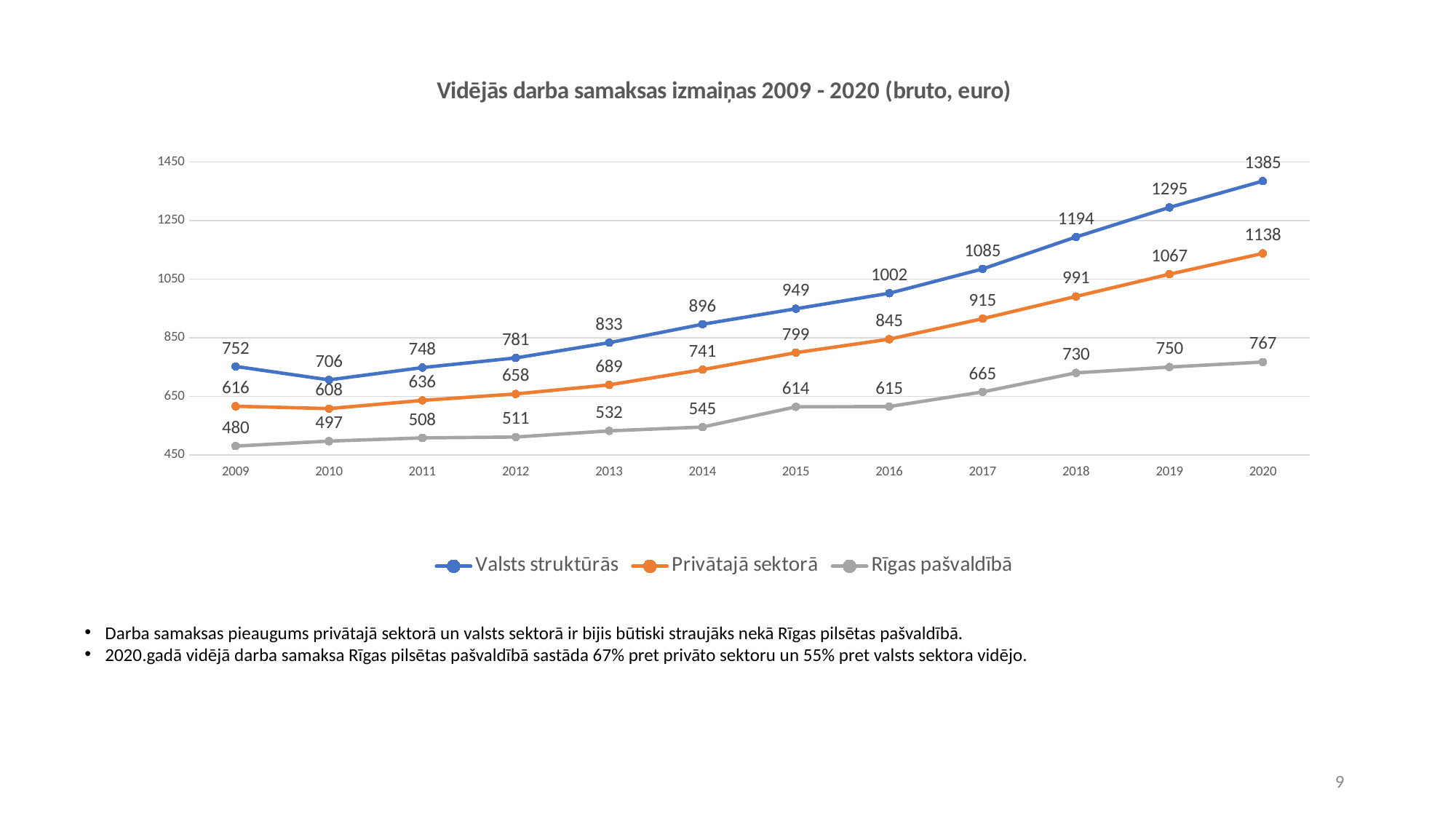
In which year is the Privātajā sektorā series at its highest? 2020 How many years are shown on the x axis? 12 What is the difference between Privātajā sektorā in 2020 and in 2009? 522 Which is larger in 2014: Privātajā sektorā or Rīgas pašvaldībā? Privātajā sektorā Does the Rīgas pašvaldībā series rise or fall from 2009 to 2020? Rise What kind of chart is shown on the slide? Line chart What is the value for Rīgas pašvaldībā in 2009? 480 What is the difference between Valsts struktūrās and Rīgas pašvaldībā in 2020? 618 How many series does the legend list? 3 What is the value for Valsts struktūrās in 2020? 1385 What is the value for Privātajā sektorā in 2015? 799 In which year is the Valsts struktūrās series at its lowest? 2010